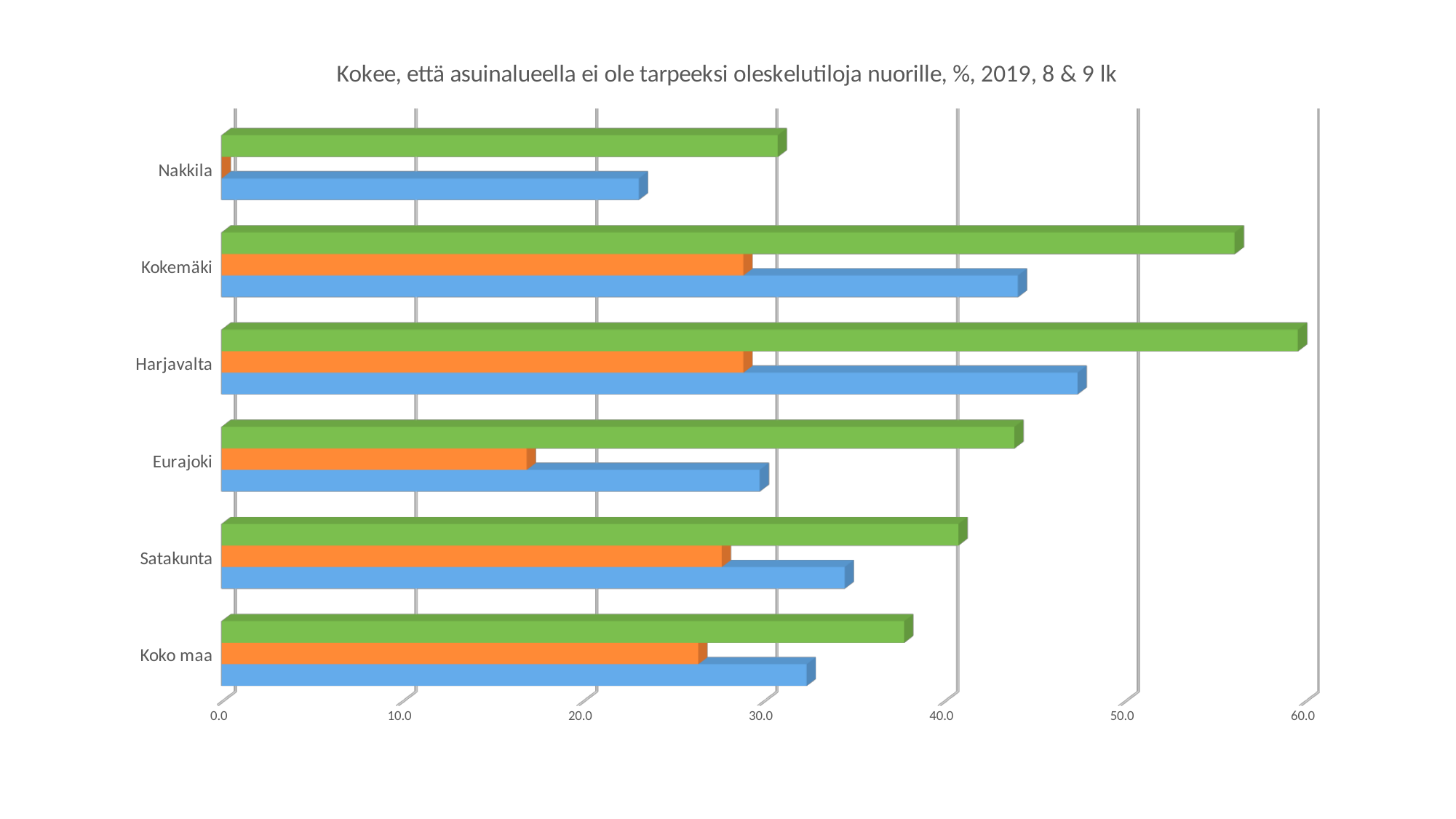
What kind of chart is shown on the slide? Bar chart Is the value of the green bar for Harjavalta greater or less than 50.0? greater Which category has the shortest green bar? Nakkila Which is larger: the green bar for Kokemäki or the green bar for Eurajoki? Kokemäki Is the value of the orange bar for Eurajoki greater or less than 20.0? less How many categories are shown on the vertical axis of the chart? 6 How many bars are shown for each category in the chart? 3 Which category has the shortest orange bar? Nakkila Which category has the longest green bar? Harjavalta Is the value of the blue bar for Nakkila greater or less than 30.0? less Which category has the longest blue bar? Harjavalta What is the title of the chart? Kokee, että asuinalueella ei ole tarpeeksi oleskelutiloja nuorille, %, 2019, 8 & 9 lk